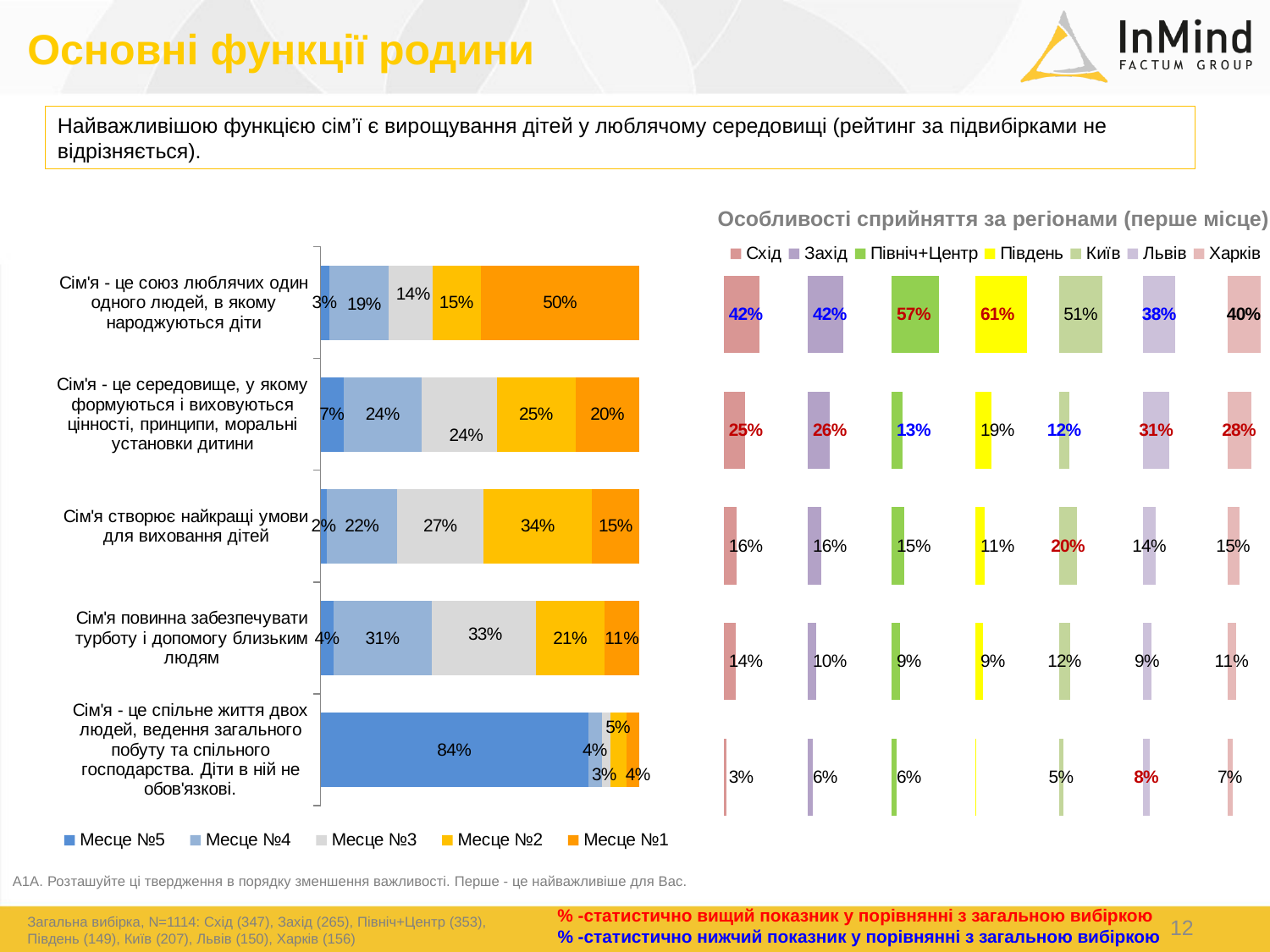
In the chart on the left, what is the value of Месце №1 for the statement 'Сім'я - це союз люблячих один одного людей, в якому народжуються діти'? 50% In the chart 'Особливості сприйняття за регіонами (перше місце)', which region has the highest value in the top row? Південь In the chart 'Особливості сприйняття за регіонами (перше місце)', what is the value for Південь in the top row? 61% In the chart on the left, what is the value of Месце №5 for the statement 'Сім'я - це спільне життя двох людей, ведення загального побуту та спільного господарства. Діти в ній не обов'язкові'? 84% In the chart 'Особливості сприйняття за регіонами (перше місце)', what is the difference between the top-row values for Північ+Центр and Схід? 15 percentage points In the chart on the left, what is the value of Месце №2 for the statement 'Сім'я створює найкращі умови для виховання дітей'? 34% In the chart on the left, how many statements (categories) are shown? 5 In the chart 'Особливості сприйняття за регіонами (перше місце)', how many regions does the legend list? 7 In the chart 'Особливості сприйняття за регіонами (перше місце)', which region has the lowest value in the top row? Львів In the chart 'Особливості сприйняття за регіонами (перше місце)', in the second row, which is larger: the value for Львів or the value for Київ? Львів What kind of chart is the chart on the left side of the slide? bar chart In the chart on the left, how many series does the legend list? 5